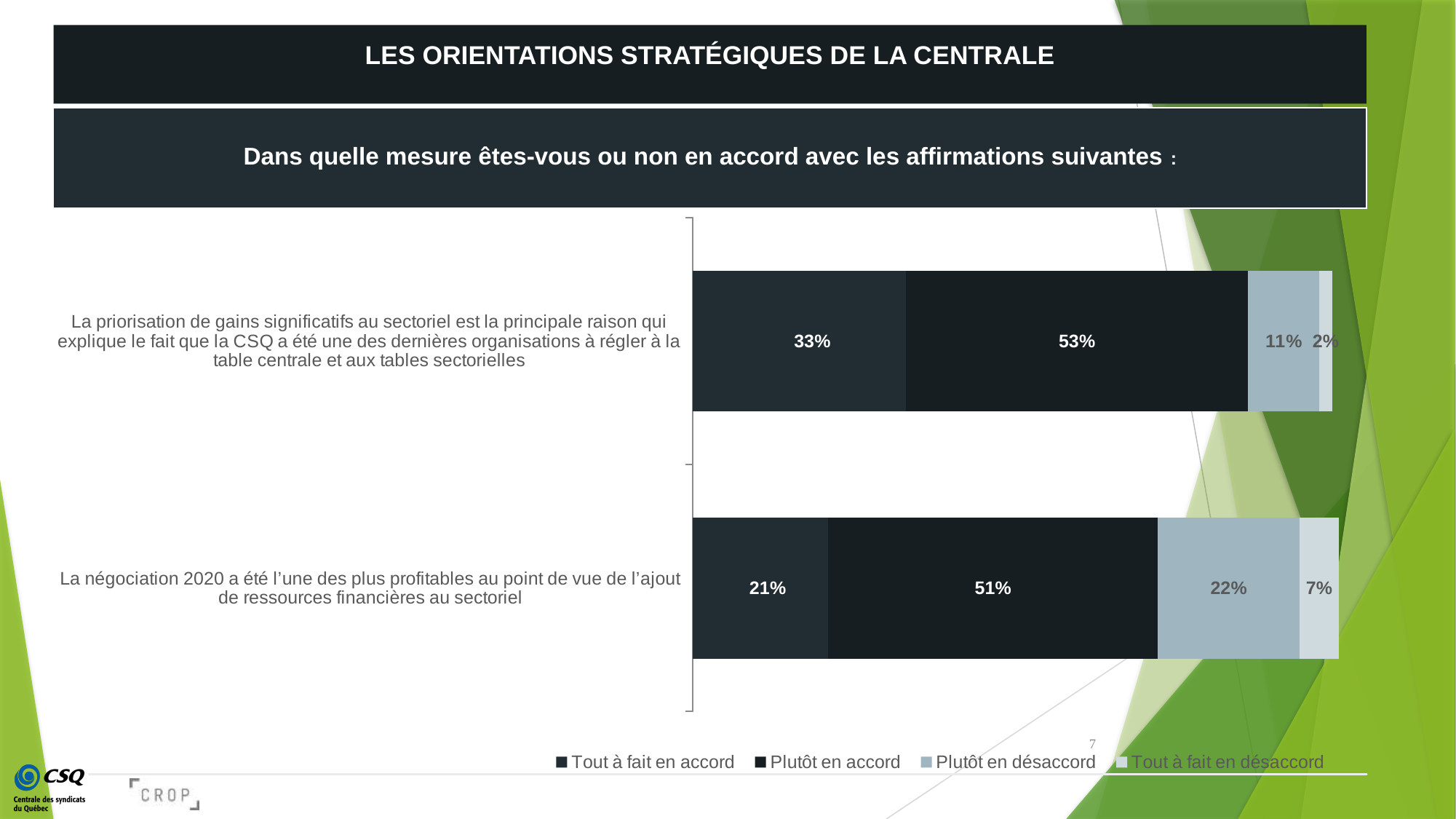
How many statements are shown in the chart? 2 How many series does the legend list? 4 What is the "Plutôt en accord" value for the statement about "La priorisation de gains significatifs au sectoriel"? 53% What is the combined share of "Tout à fait en accord" and "Plutôt en accord" for the statement "La négociation 2020 a été l'une des plus profitables..."? 72% What is the "Plutôt en désaccord" value for the statement "La négociation 2020 a été l'une des plus profitables..."? 22% What is the "Tout à fait en désaccord" value for the statement about "La priorisation de gains significatifs au sectoriel"? 2% What is the difference between the "Plutôt en désaccord" values of the two statements? 11% Which response category has the lowest value for the statement "La négociation 2020 a été l'une des plus profitables..."? Tout à fait en désaccord What percentage of respondents answered "Tout à fait en accord" for the statement "La négociation 2020 a été l'une des plus profitables au point de vue de l'ajout de ressources financières au sectoriel"? 21% Is the "Plutôt en accord" value larger for the statement about "La priorisation de gains significatifs" or for the statement about "La négociation 2020"? La priorisation de gains significatifs au sectoriel What kind of chart is shown on the slide? Stacked bar chart